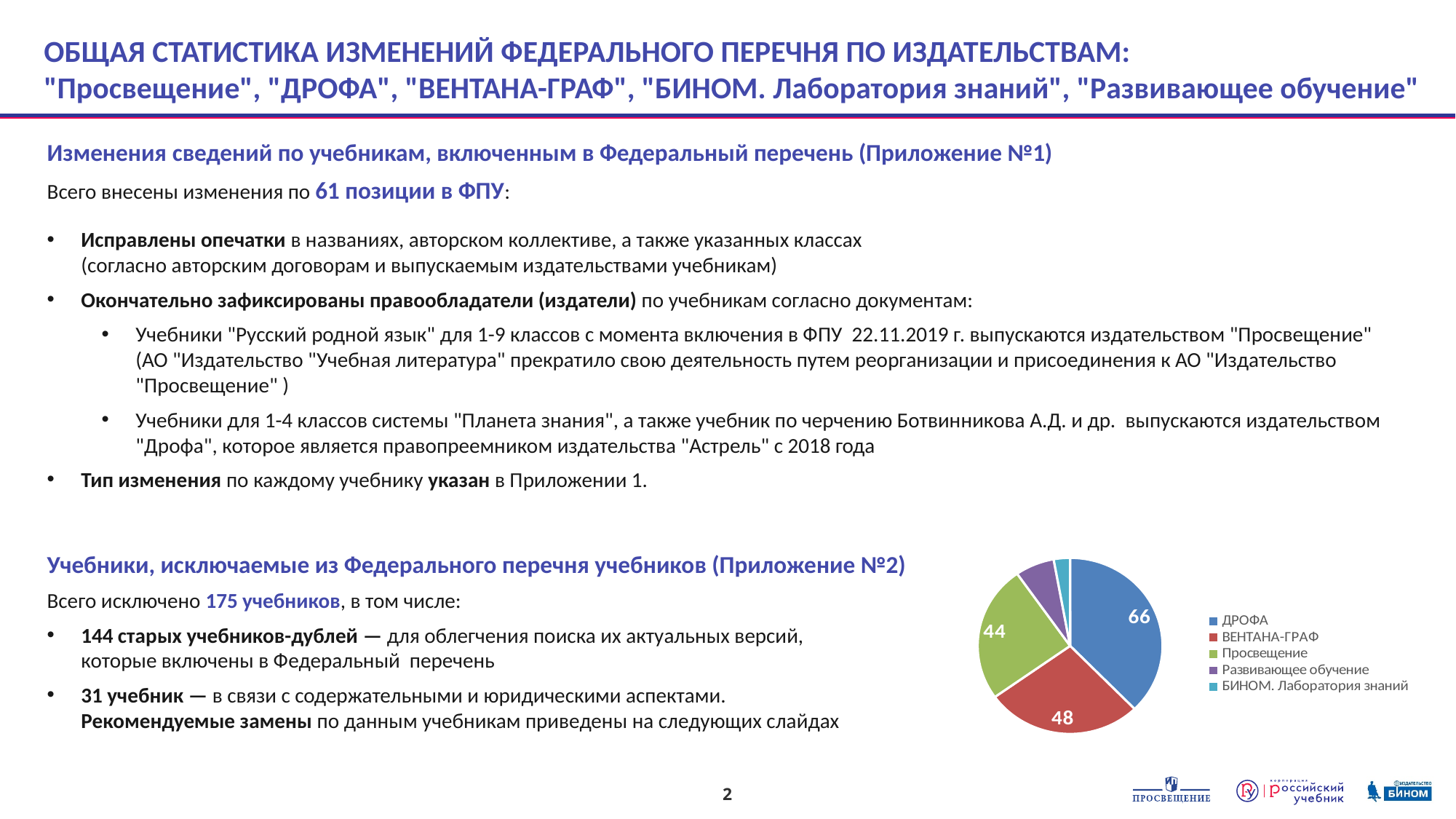
Which publisher has the largest slice in the pie chart? ДРОФА What kind of chart is shown on the slide? pie chart What is the value shown for ДРОФА in the pie chart? 66 Which is larger in the pie chart, the value for ДРОФА or the value for Просвещение? ДРОФА How many slices does the pie chart have? 5 What is the difference between the values for ВЕНТАНА-ГРАФ and Просвещение in the pie chart? 4 What is the difference between the values for ДРОФА and ВЕНТАНА-ГРАФ in the pie chart? 18 How many entries does the legend of the pie chart list? 5 What is the value shown for ВЕНТАНА-ГРАФ in the pie chart? 48 What colour is the ДРОФА slice in the pie chart? blue What is the value shown for Просвещение in the pie chart? 44 Which publisher has the smallest slice in the pie chart? БИНОМ. Лаборатория знаний